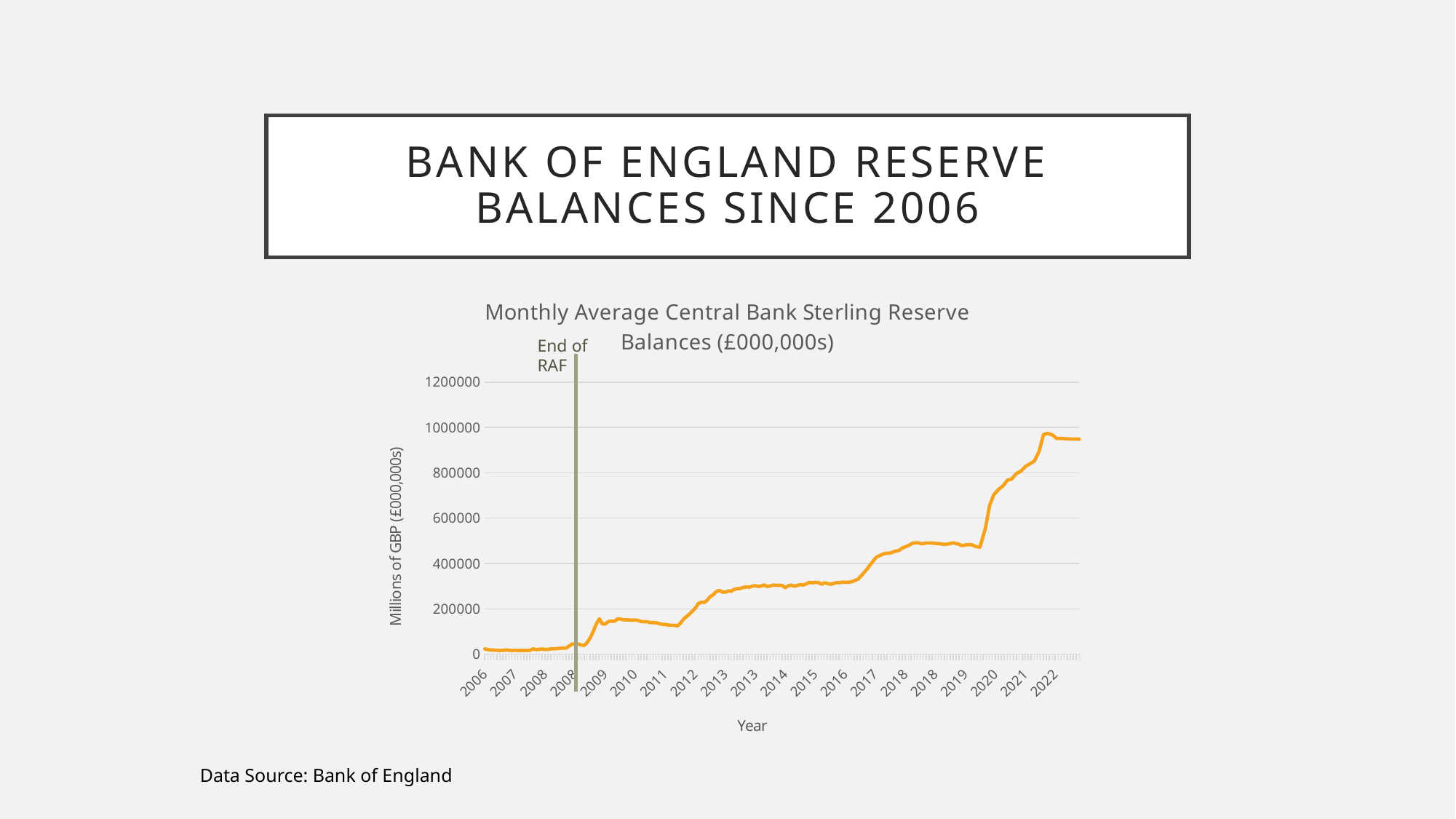
Is the value for 2006 greater or less than 200000? less What is the title of the chart? Monthly Average Central Bank Sterling Reserve Balances (£000,000s) Is the value for 2022 greater or less than 800000? greater Is the value for 2018 greater or less than 400000? greater Which year shown has the higher reserve balance, 2008 or 2017? 2017 Do the reserve balances generally rise or fall from 2006 to 2022? rise Which year shown has the higher reserve balance, 2012 or 2021? 2021 What event does the vertical line on the chart mark? End of RAF What kind of chart is shown on the slide? line chart